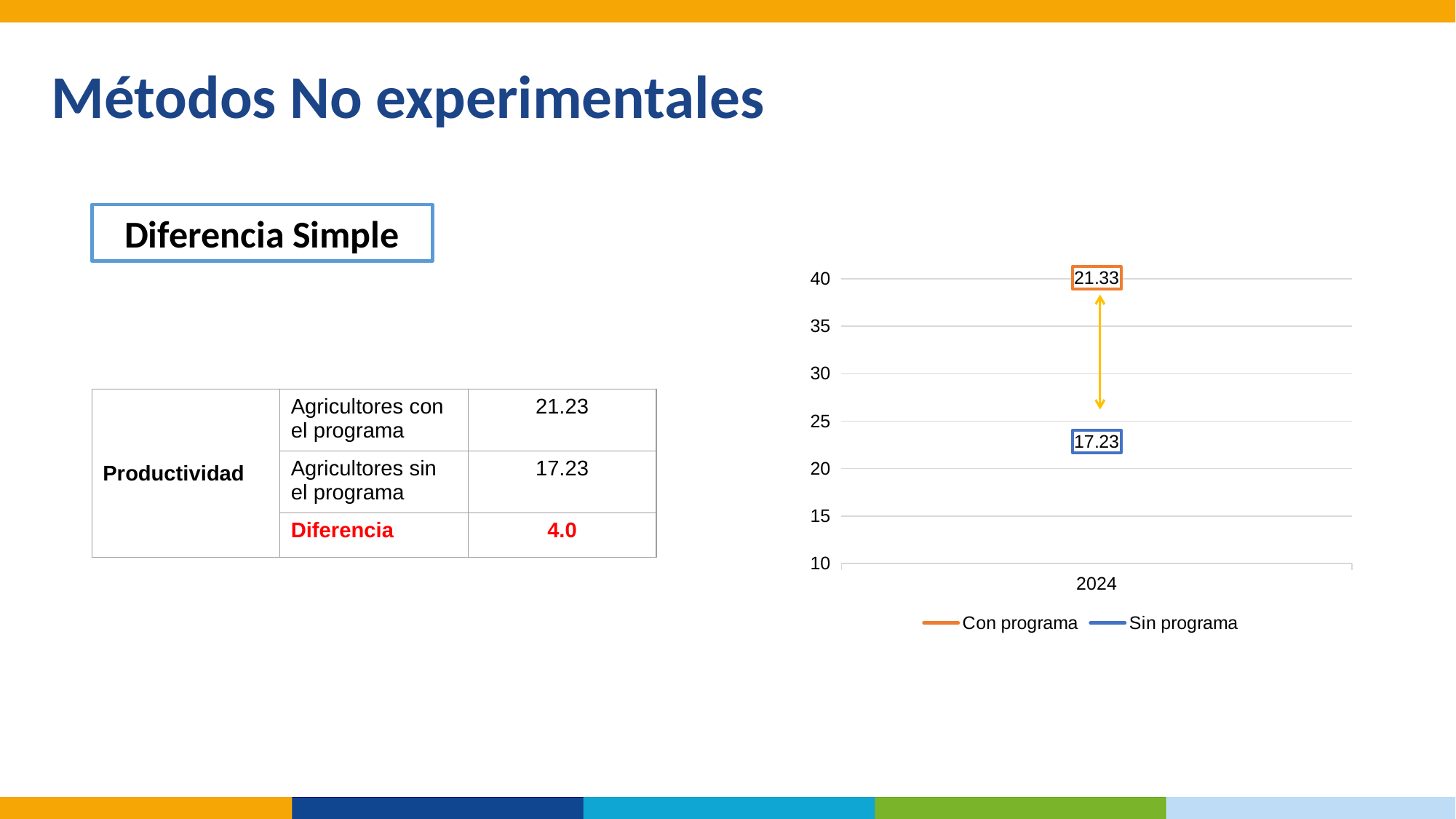
How many series does the chart legend list? 2 Which series has the higher value in 2024, Con programa or Sin programa? Con programa What year is shown on the x axis of the chart? 2024 Is the value for Con programa greater or less than 20? greater What is the value for Sin programa in 2024 on the chart? 17.23 Which series has the lowest value on the chart? Sin programa What is the highest value shown on the chart's y axis? 40 How many categories are shown on the x axis of the chart? 1 Is the value for Sin programa greater or less than 20? less What is the value for Con programa in 2024 on the chart? 21.33